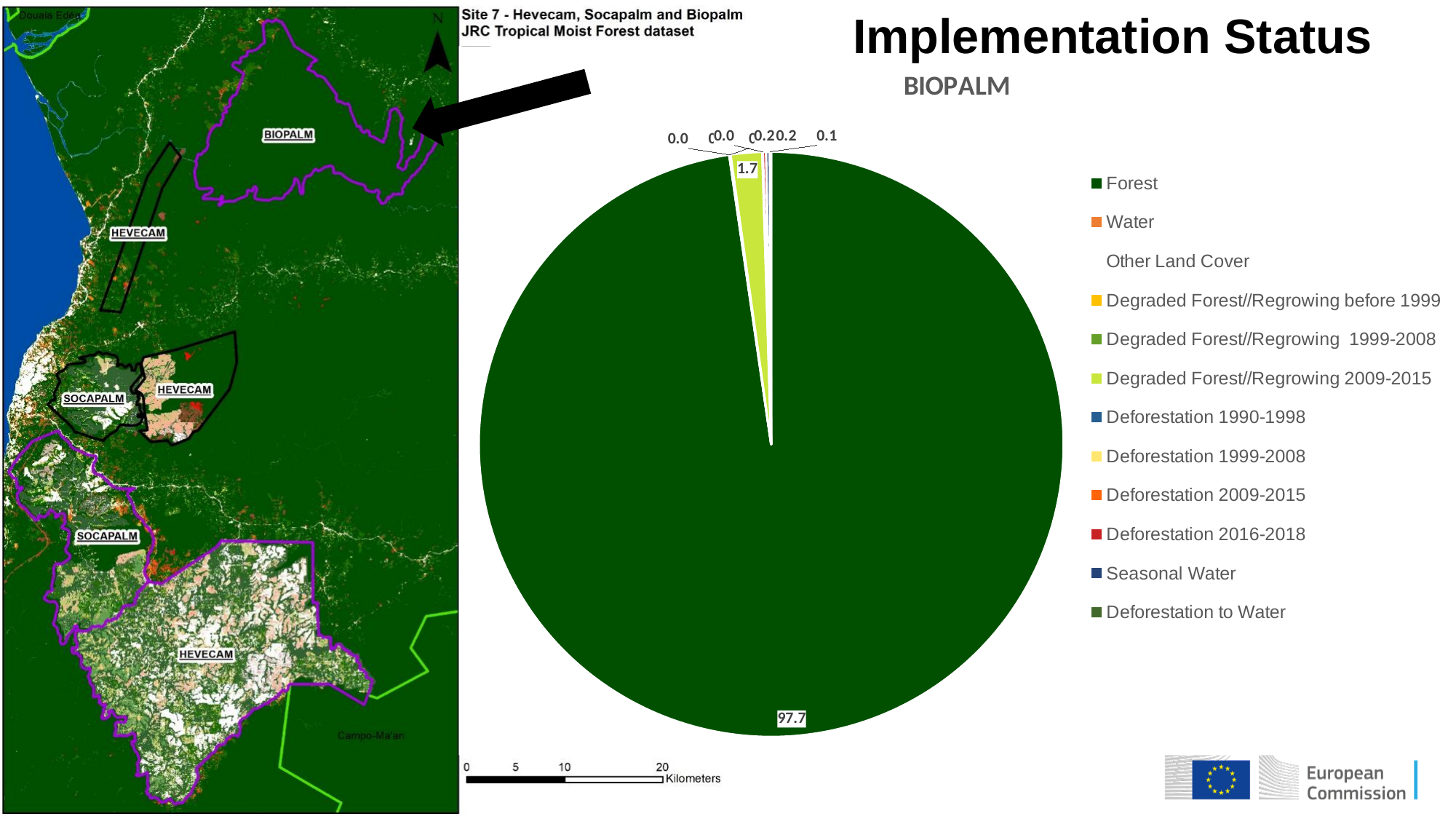
What is the title of the pie chart on the slide? BIOPALM In the BIOPALM pie chart, which is larger: Forest or Degraded Forest//Regrowing 2009-2015? Forest What value is shown for the Degraded Forest//Regrowing 2009-2015 slice of the BIOPALM pie chart? 1.7 Which category has the largest slice in the BIOPALM pie chart? Forest What value is shown for the Forest slice of the BIOPALM pie chart? 97.7 How many categories are listed in the legend of the BIOPALM pie chart? 12 What colour is used for the Forest category in the BIOPALM pie chart legend? Dark green What is the difference between the Forest value and the Degraded Forest//Regrowing 2009-2015 value in the BIOPALM pie chart? 96.0 What share of the BIOPALM pie does the Forest slice represent? 97.7 What kind of chart is used to show the BIOPALM land cover data? Pie chart